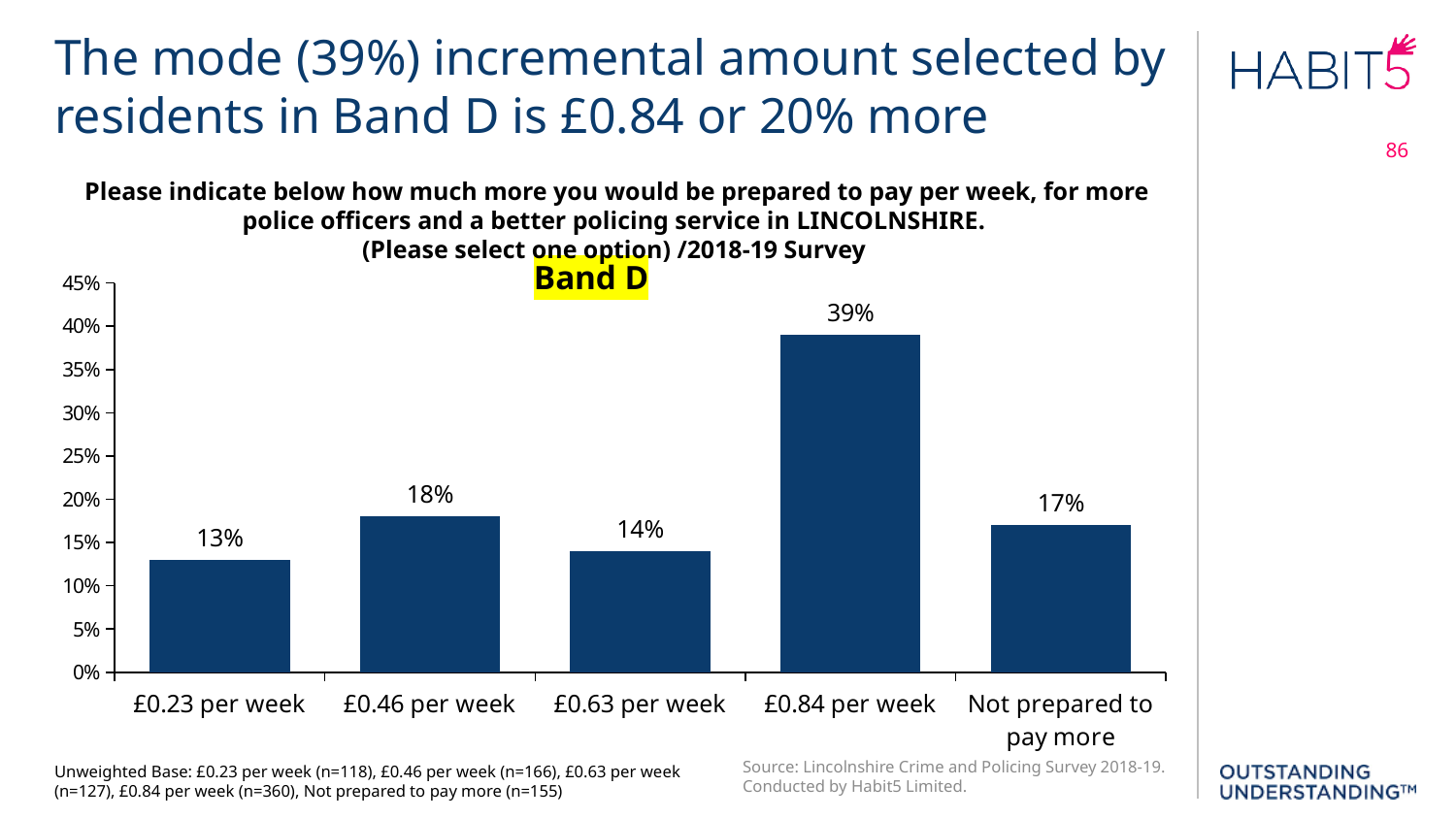
Which option has the highest percentage in the chart? £0.84 per week Which is larger: the value for £0.46 per week or the value for £0.63 per week? £0.46 per week What kind of chart is shown on the slide? Bar chart What percentage of Band D residents selected £0.84 per week? 39% How many categories are shown on the x axis of the chart? 5 Which council tax band is highlighted in the chart title? Band D What is the difference in percentage points between £0.84 per week and £0.46 per week? 21 Is the value for £0.84 per week greater or less than 35%? greater What percentage of Band D residents were not prepared to pay more? 17% Which option has the lowest percentage in the chart? £0.23 per week What percentage of Band D residents selected £0.23 per week? 13% What is the difference in percentage points between 'Not prepared to pay more' and £0.63 per week? 3